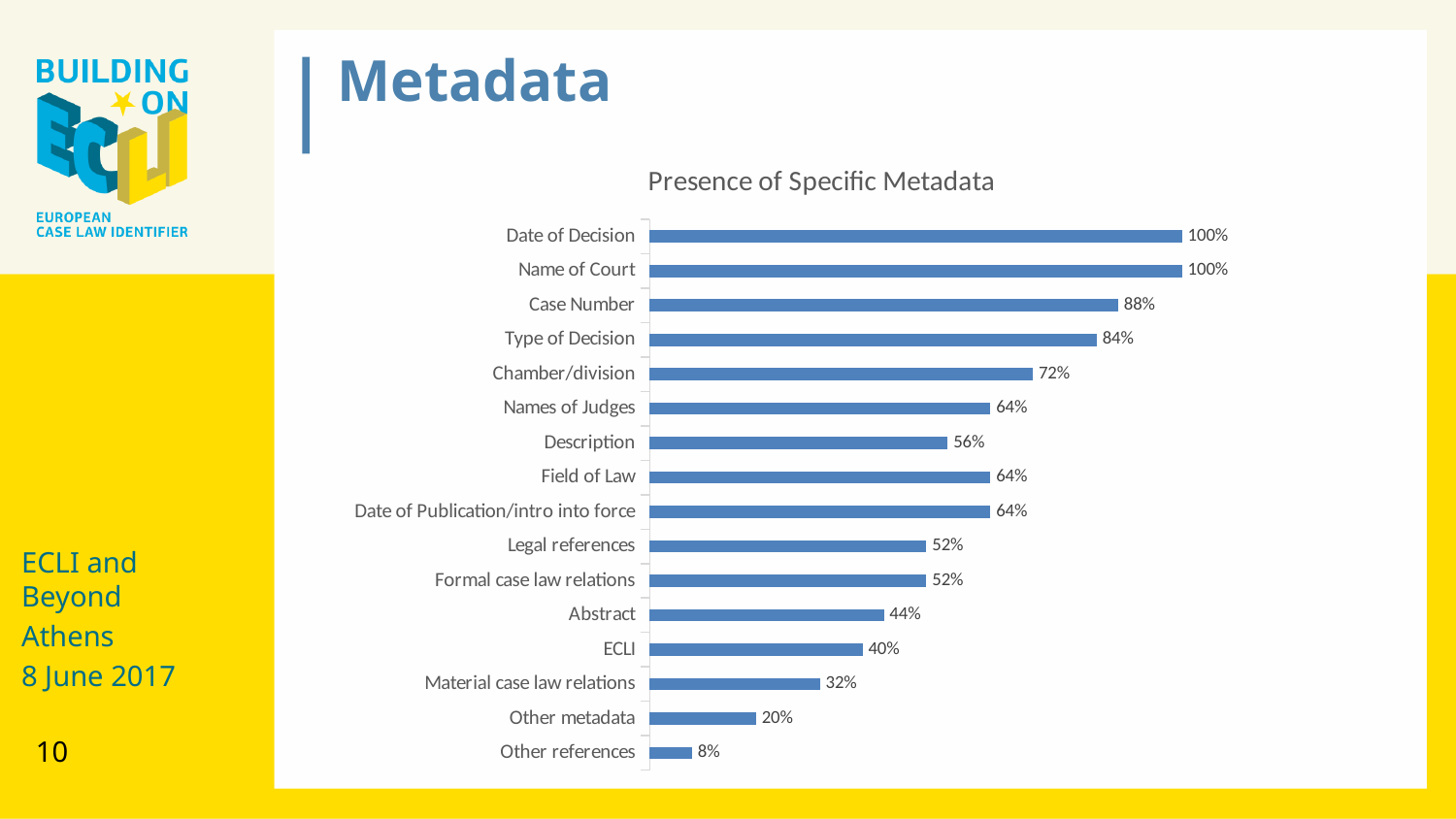
What is the value for Material case law relations? 32% Which is larger, the value for Description or the value for Abstract? Description What is the difference between the values for Type of Decision and ECLI? 44% What is the value for Chamber/division? 72% Which two categories both have a value of 100%? Date of Decision and Name of Court How many categories are shown in the chart? 16 What is the difference between the values for Other metadata and Other references? 12% What kind of chart is shown on the slide? Bar chart What is the title of the chart? Presence of Specific Metadata Which category has the lowest value? Other references What is the value for Case Number? 88% What is the value for Other references? 8%